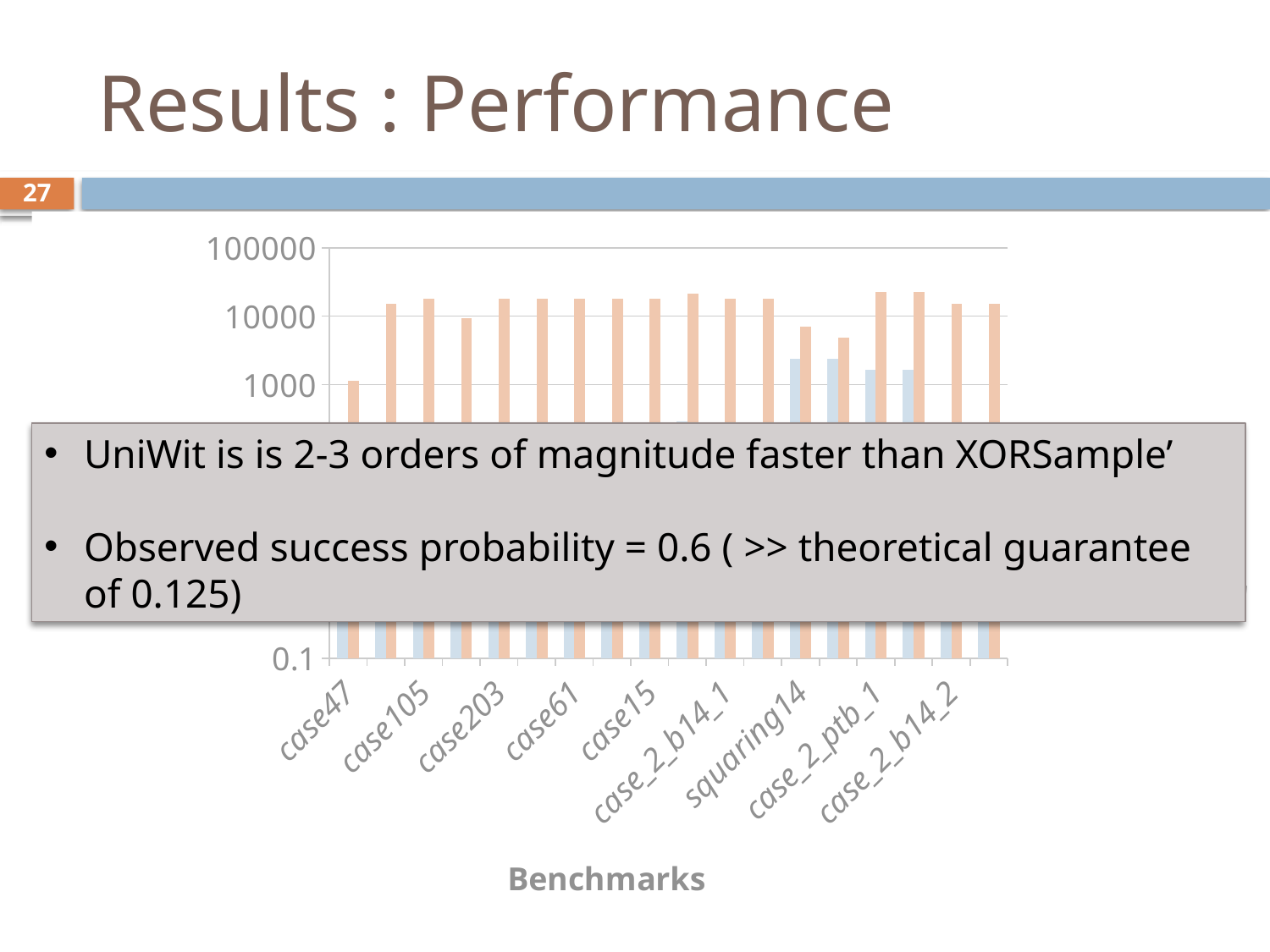
Is the blue bar for squaring14 greater or less than 1000? greater What kind of chart is shown on the slide? bar chart Is the blue bar for case_2_ptb_1 greater or less than 1000? greater Is the orange bar for case_2_b14_2 greater or less than 10000? greater What is the title of the x axis of the chart? Benchmarks What is the highest value shown on the y axis of the chart? 100000 Among the labelled benchmarks, which has the lowest orange bar? case47 For case105, which bar is taller, the orange one or the blue one? orange